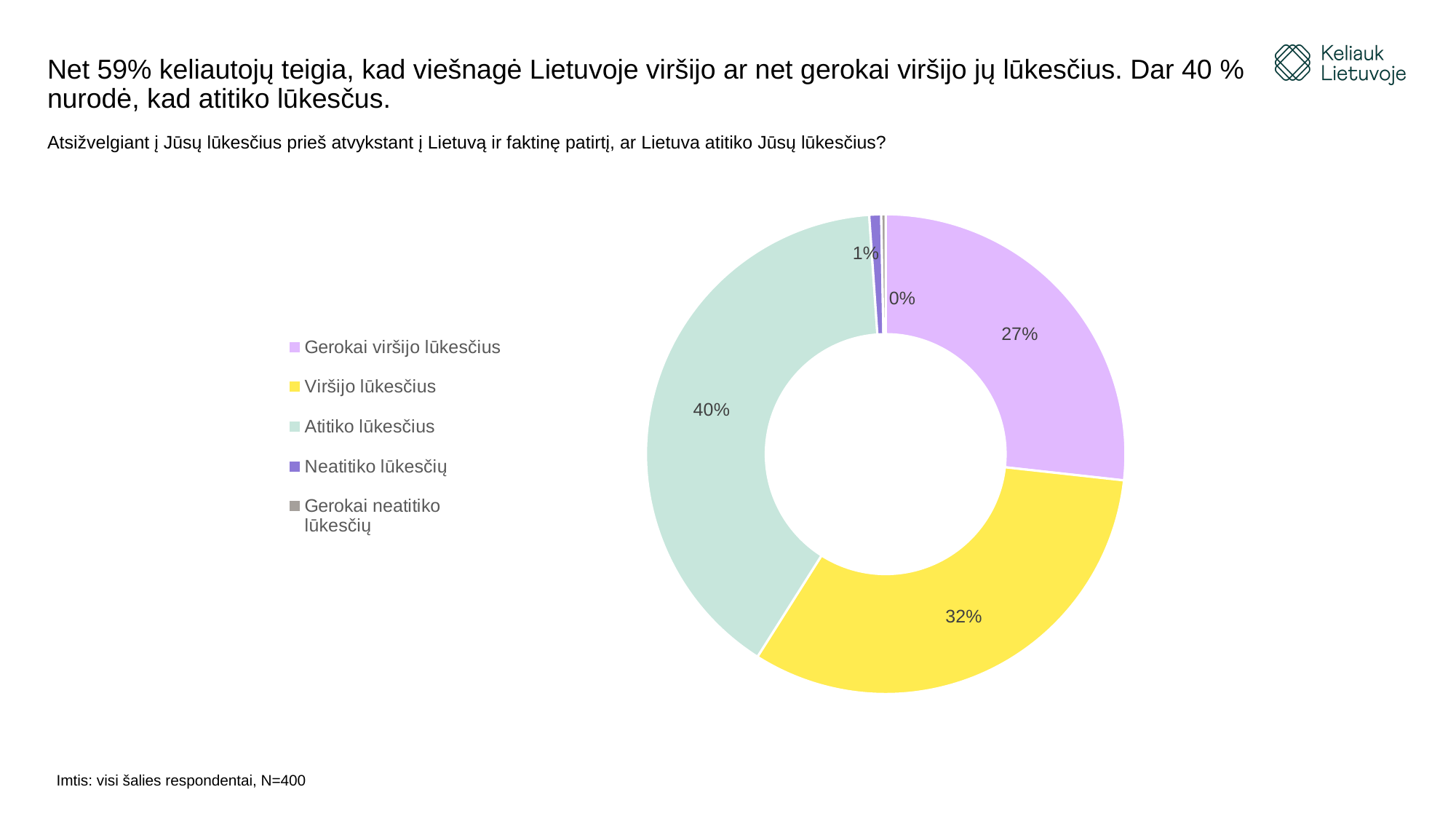
Which category has the smallest share of the chart? Gerokai neatitiko lūkesčių What share of respondents answered "Gerokai viršijo lūkesčius"? 27% What is the combined share of "Gerokai viršijo lūkesčius" and "Viršijo lūkesčius"? 59% What share of respondents answered "Atitiko lūkesčius"? 40% What colour is the "Atitiko lūkesčius" slice? Light green (mint) Which category has the largest share of the chart? Atitiko lūkesčius Which is larger: the share for "Viršijo lūkesčius" or the share for "Gerokai viršijo lūkesčius"? Viršijo lūkesčius What kind of chart is shown on the slide? Doughnut (pie) chart What share of respondents answered "Viršijo lūkesčius"? 32% What is the difference in percentage points between "Atitiko lūkesčius" and "Gerokai viršijo lūkesčius"? 13 percentage points How many categories does the chart show? 5 What share of respondents answered "Neatitiko lūkesčių"? 1%